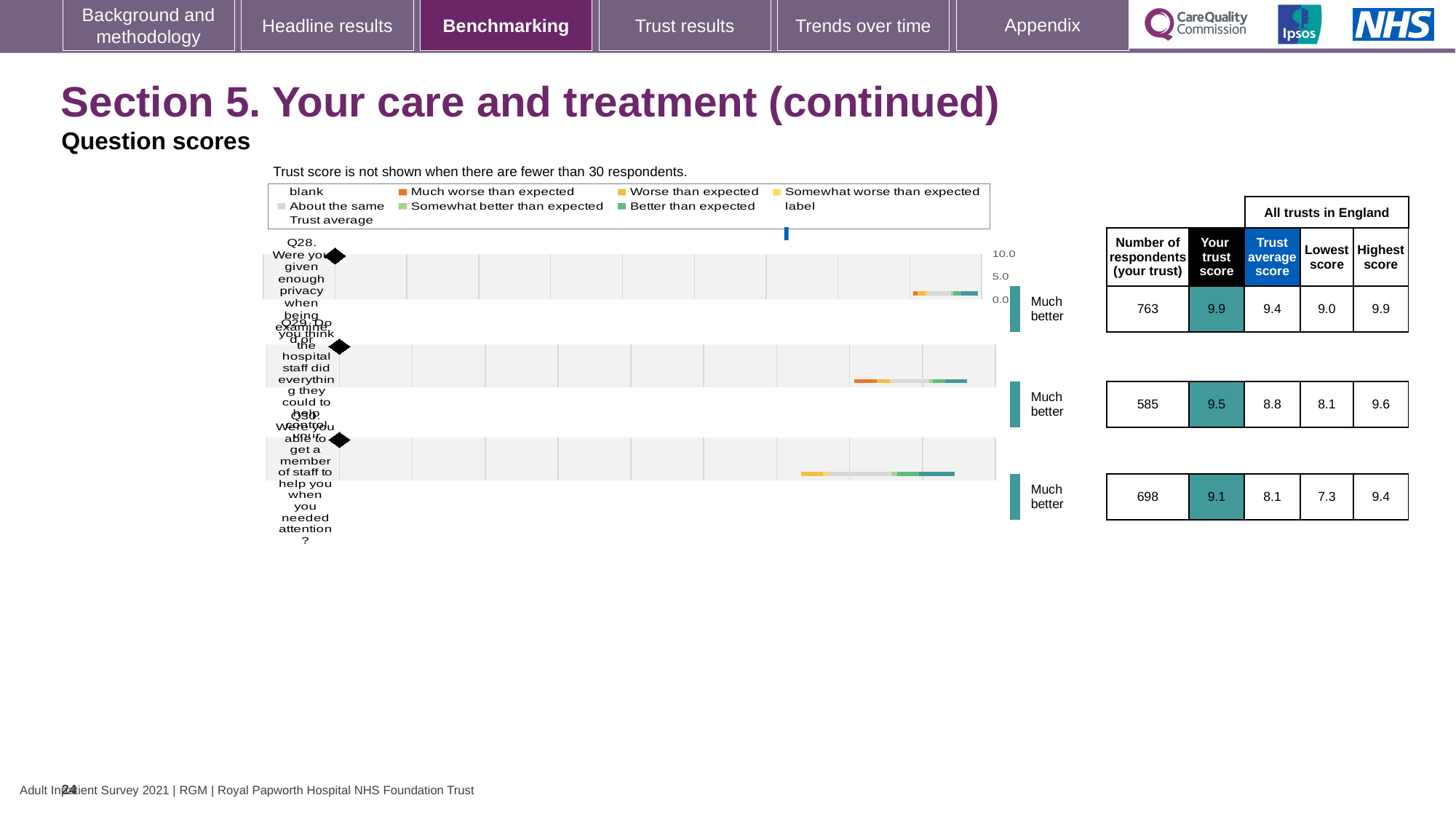
Which question has the highest 'Your trust score'? Q28 What is the difference between the 'Your trust score' and the 'Trust average score' for Q28? 0.5 Which question has the lowest 'Your trust score'? Q30 Which has a higher 'Your trust score', Q29 or Q30? Q29 How many questions are plotted in the chart? 3 What is the 'Trust average score' for Q29? 8.8 What is the 'Highest score' across all trusts in England for Q29? 9.6 What kind of chart is used to show the question scores on this slide? bar chart What is the difference between the 'Highest score' and the 'Lowest score' for Q30? 2.1 What is the 'Your trust score' for Q28? 9.9 How many respondents from your trust answered Q30? 698 Which legend entry is shown in orange? Much worse than expected